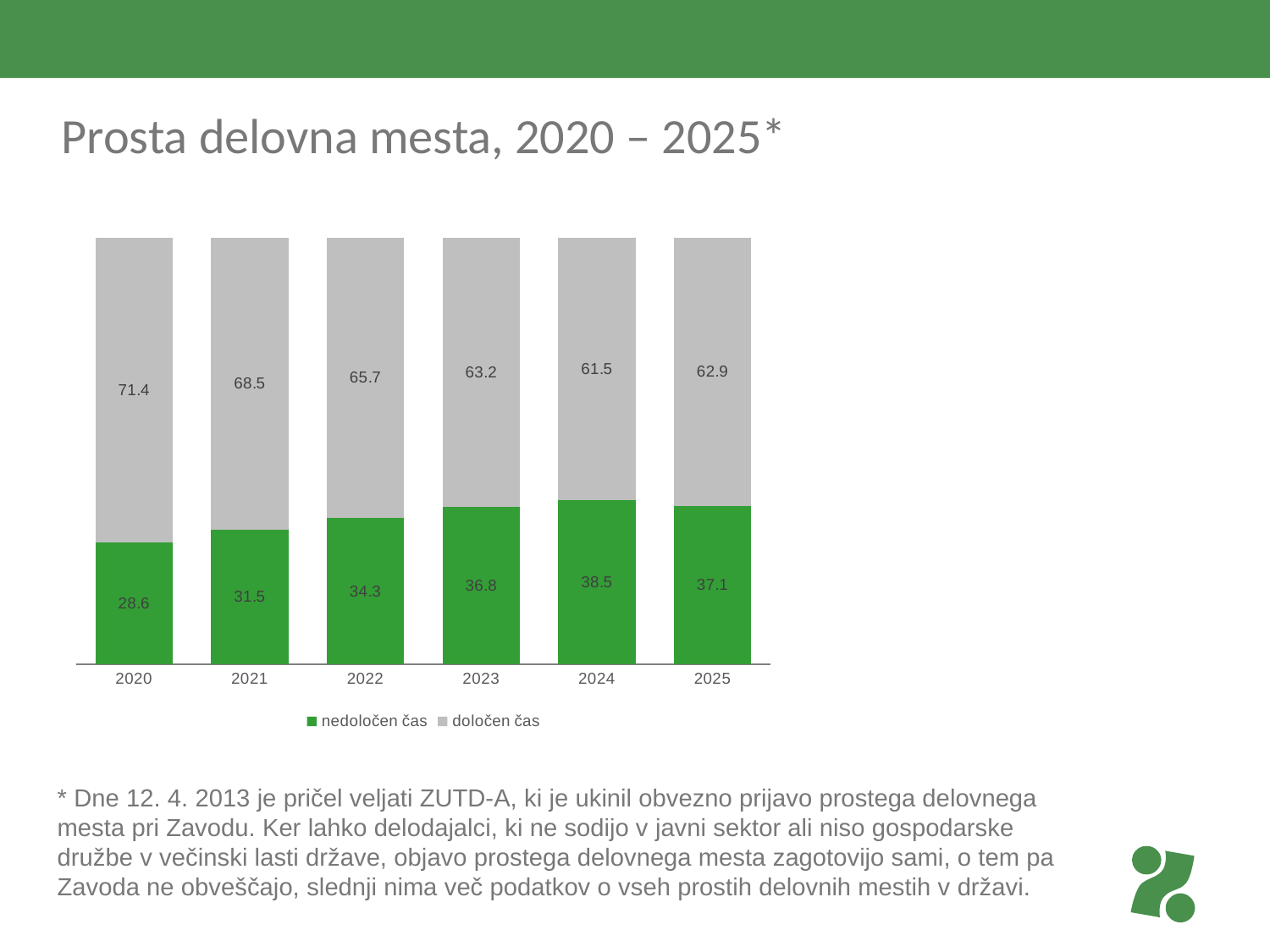
In which year is the value for "določen čas" lowest? 2024 What kind of chart is shown on the slide? Stacked bar chart Does the value for "določen čas" rise or fall from 2020 to 2024? Fall Which is larger: the "določen čas" value for 2021 or for 2022? 2021 In which year is the value for "nedoločen čas" highest? 2024 How many years are shown on the x axis? 6 What is the value for "nedoločen čas" in 2025? 37.1 What is the value for "določen čas" in 2023? 63.2 What is the difference between the "nedoločen čas" values for 2024 and 2020? 9.9 How many series does the legend list? 2 What is the value for "nedoločen čas" in 2020? 28.6 What is the total of the stacked bar for 2022? 100